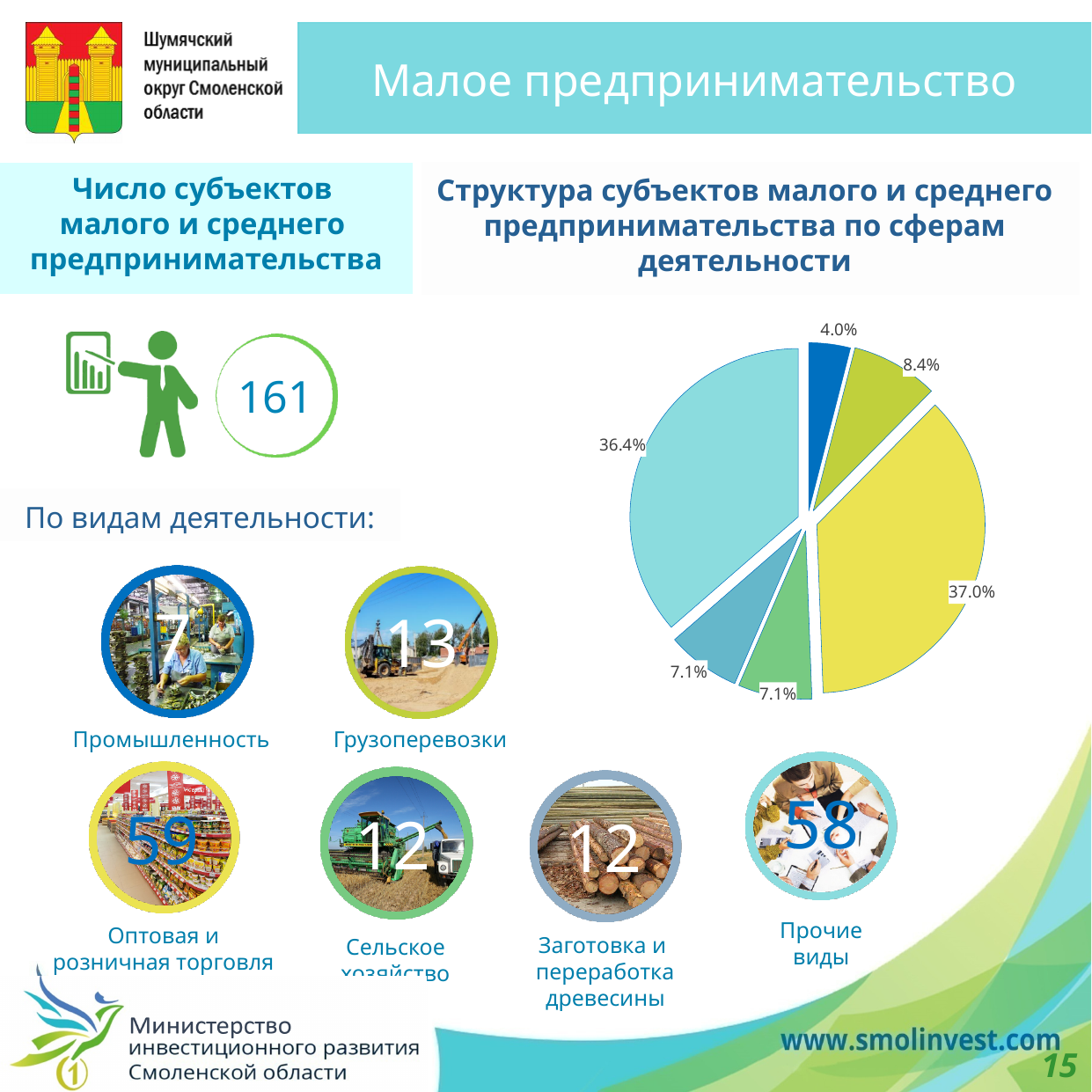
What is the value of the smallest slice in the pie chart? 4.0% What is the value of the largest slice in the pie chart? 37.0% How many slices does the pie chart have? 6 How many slices in the pie chart are labelled 7.1%? 2 What is the value of the light cyan slice on the left side of the pie chart? 36.4% What is the value of the dark blue slice at the top of the pie chart? 4.0% What is the title of the pie chart on the slide? Структура субъектов малого и среднего предпринимательства по сферам деятельности What is the difference between the 37.0% slice and the 36.4% slice in the pie chart? 0.6% What is the value of the yellow-green slice next to the 4.0% slice in the pie chart? 8.4% Is the largest slice of the pie chart greater or less than 30%? greater Which is larger in the pie chart: the 8.4% slice or the 4.0% slice? 8.4% What kind of chart is shown under the title "Структура субъектов малого и среднего предпринимательства по сферам деятельности"? pie chart